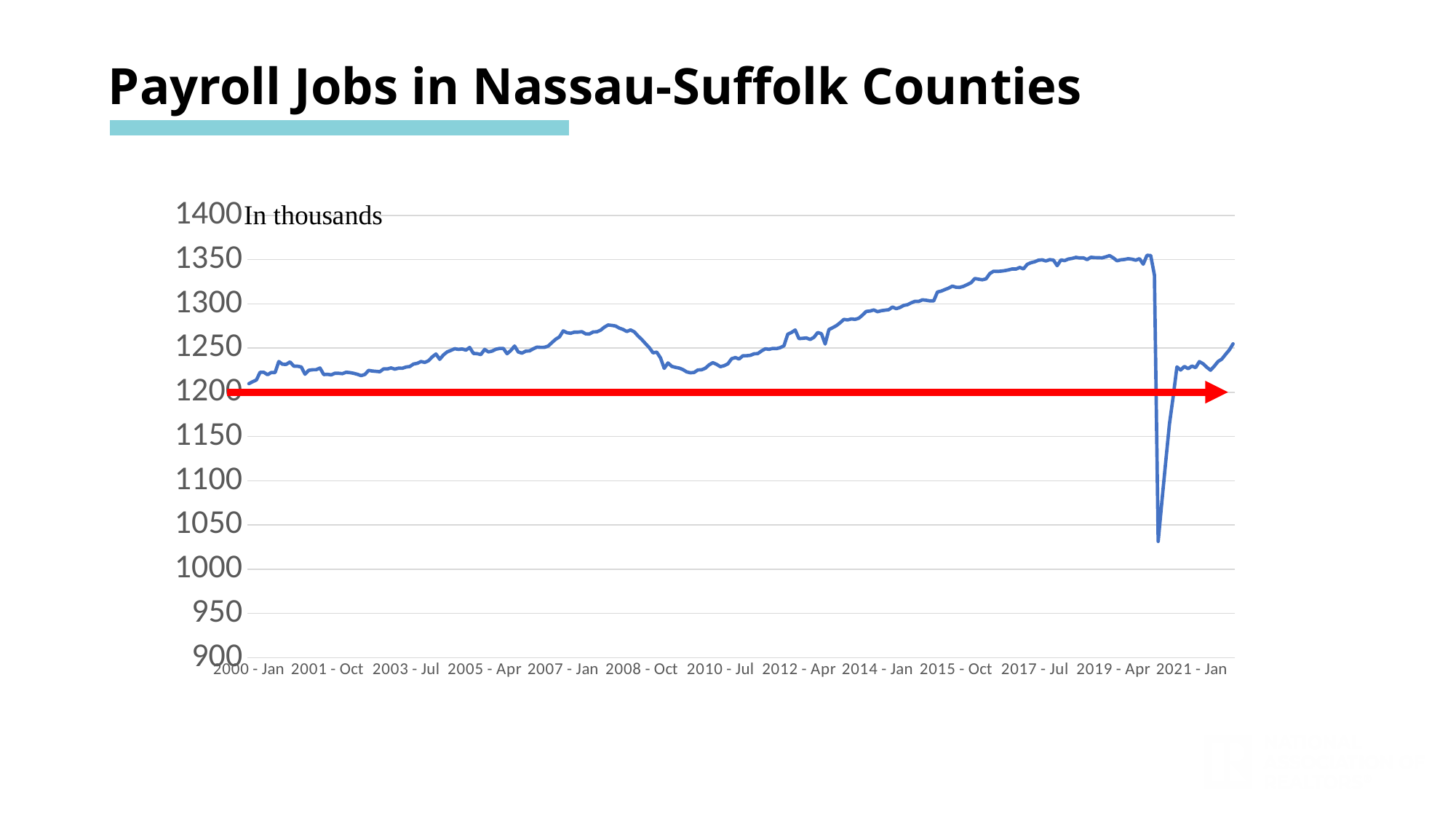
Is the value at 2010 - Jul greater or less than 1250? less Is the value at 2014 - Jan greater or less than 1250? greater Is the value at 2000 - Jan greater or less than 1250? less How many date labels are shown on the x axis? 13 What kind of chart is shown on the slide? Line chart What is the title of the chart on the slide? Payroll Jobs in Nassau-Suffolk Counties Does the line rise or fall between 2010 - Jul and 2019 - Apr? rise At which value on the vertical axis is the red horizontal arrow drawn? 1200